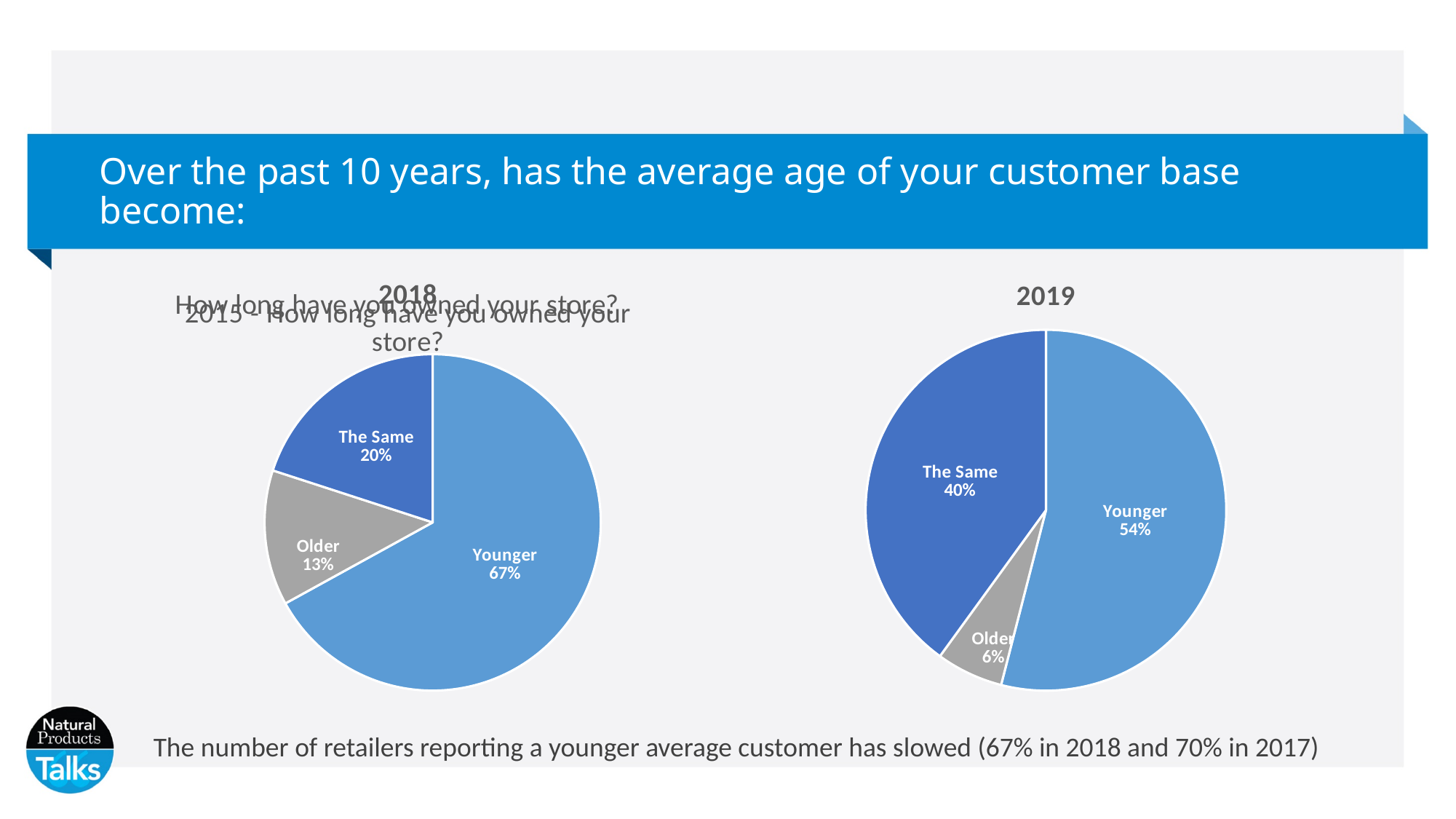
In the 2018 pie chart, which category has the largest slice? Younger What type of chart is used to show the 2018 data? Pie chart Which is larger: the Older share in 2018 or the Older share in 2019? 2018 What is the difference between The Same share in 2019 and The Same share in 2018? 20% In the 2019 pie chart, which category has the smallest slice? Older In the 2018 pie chart, what is the value for Older? 13% In the 2019 pie chart, what share of retailers reported the average customer age as the same? 40% How many slices does the 2019 pie chart have? 3 In the 2018 pie chart, what share of retailers reported a younger average customer? 67% In the 2019 pie chart, what is the value for Older? 6% What colour is the Older slice in both pie charts? Grey In the 2019 pie chart, what is the difference between the Younger and The Same shares? 14%